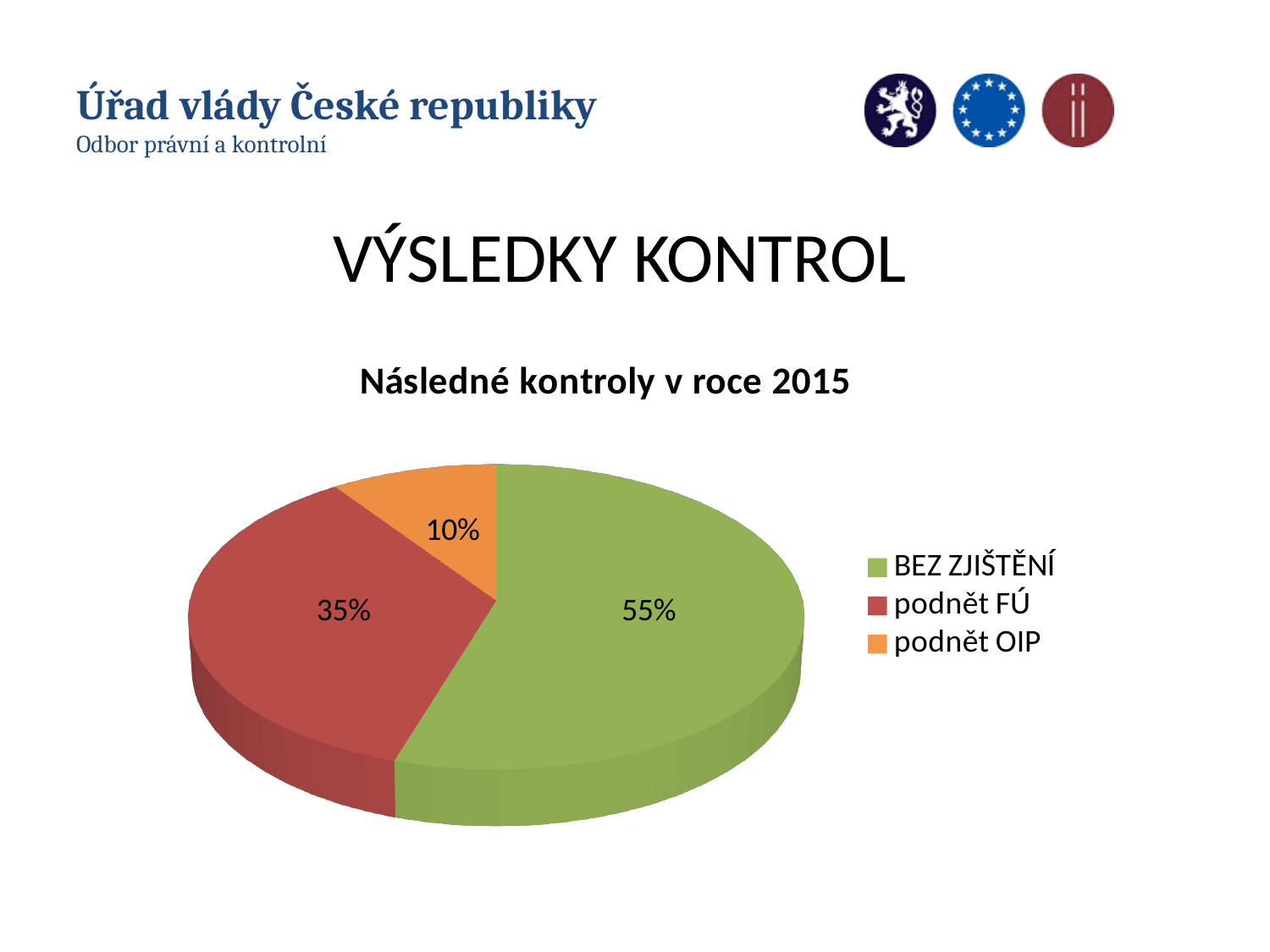
Which category has the smallest slice of the pie? podnět OIP What is the title of the chart? Následné kontroly v roce 2015 How many slices does the pie chart have? 3 What share of the pie is labelled podnět FÚ? 35% Which is larger, the podnět FÚ slice or the podnět OIP slice? podnět FÚ Which category has the largest slice of the pie? BEZ ZJIŠTĚNÍ What is the difference in percentage points between the BEZ ZJIŠTĚNÍ slice and the podnět FÚ slice? 20% What share of the pie is labelled podnět OIP? 10% What colour is the podnět OIP slice? orange What kind of chart is shown on the slide? pie chart What is the difference in percentage points between the podnět FÚ slice and the podnět OIP slice? 25% What share of the pie is labelled BEZ ZJIŠTĚNÍ? 55%